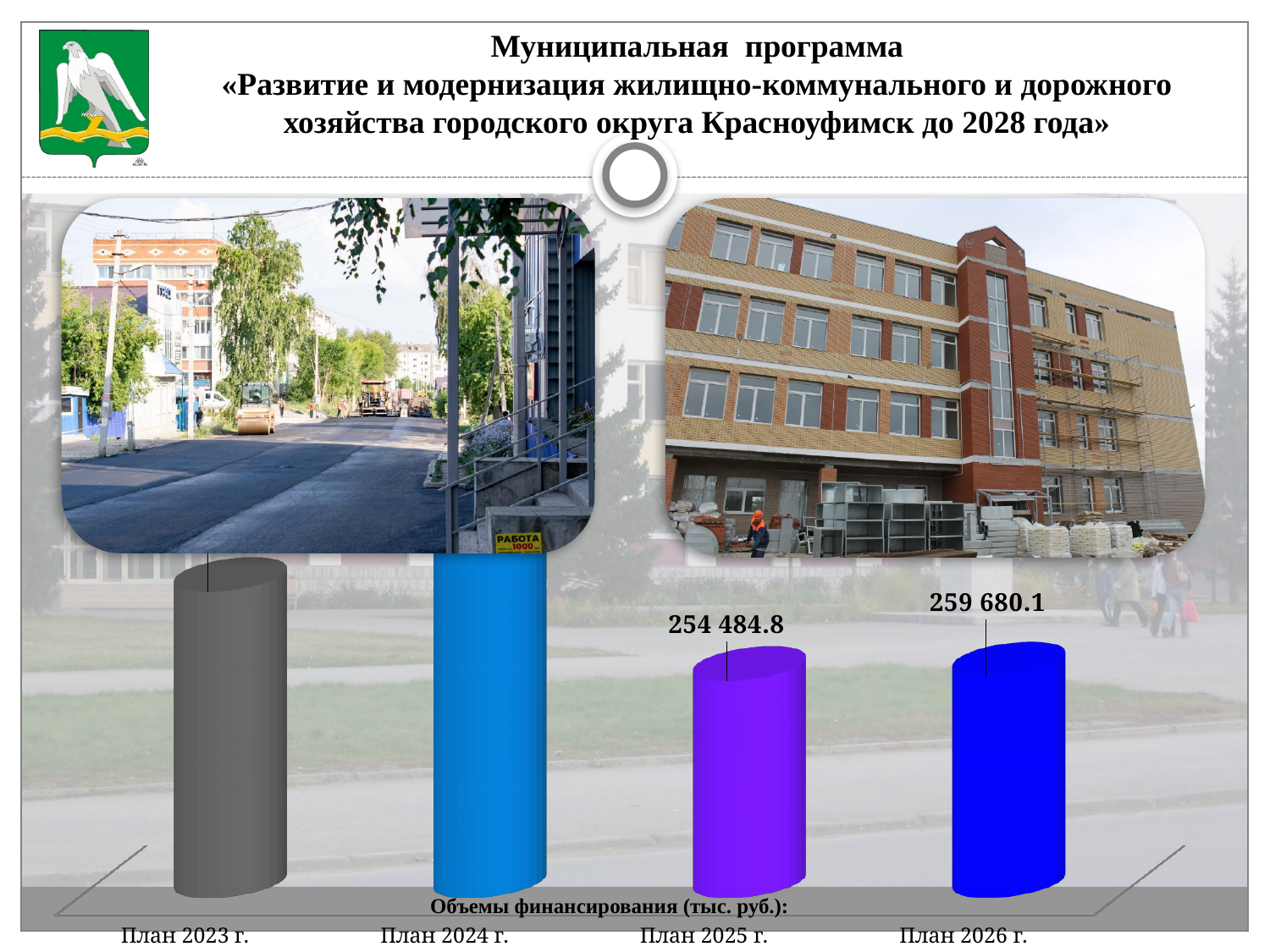
Which is larger, the value for План 2023 г. or План 2025 г.? План 2023 г. Which category has the highest value? План 2024 г. What is the value for План 2026 г.? 259 680.1 What is the difference between the values for План 2026 г. and План 2025 г.? 5 195.3 Does the value rise or fall from План 2025 г. to План 2026 г.? Rise How many categories are shown in the chart? 4 What kind of chart is shown on the slide? Bar chart Which category has the lowest value? План 2025 г. What colour is the bar for План 2023 г.? Grey What is the title of the chart? Объемы финансирования (тыс. руб.): What is the value for План 2025 г.? 254 484.8 Which is larger, the value for План 2025 г. or План 2026 г.? План 2026 г.